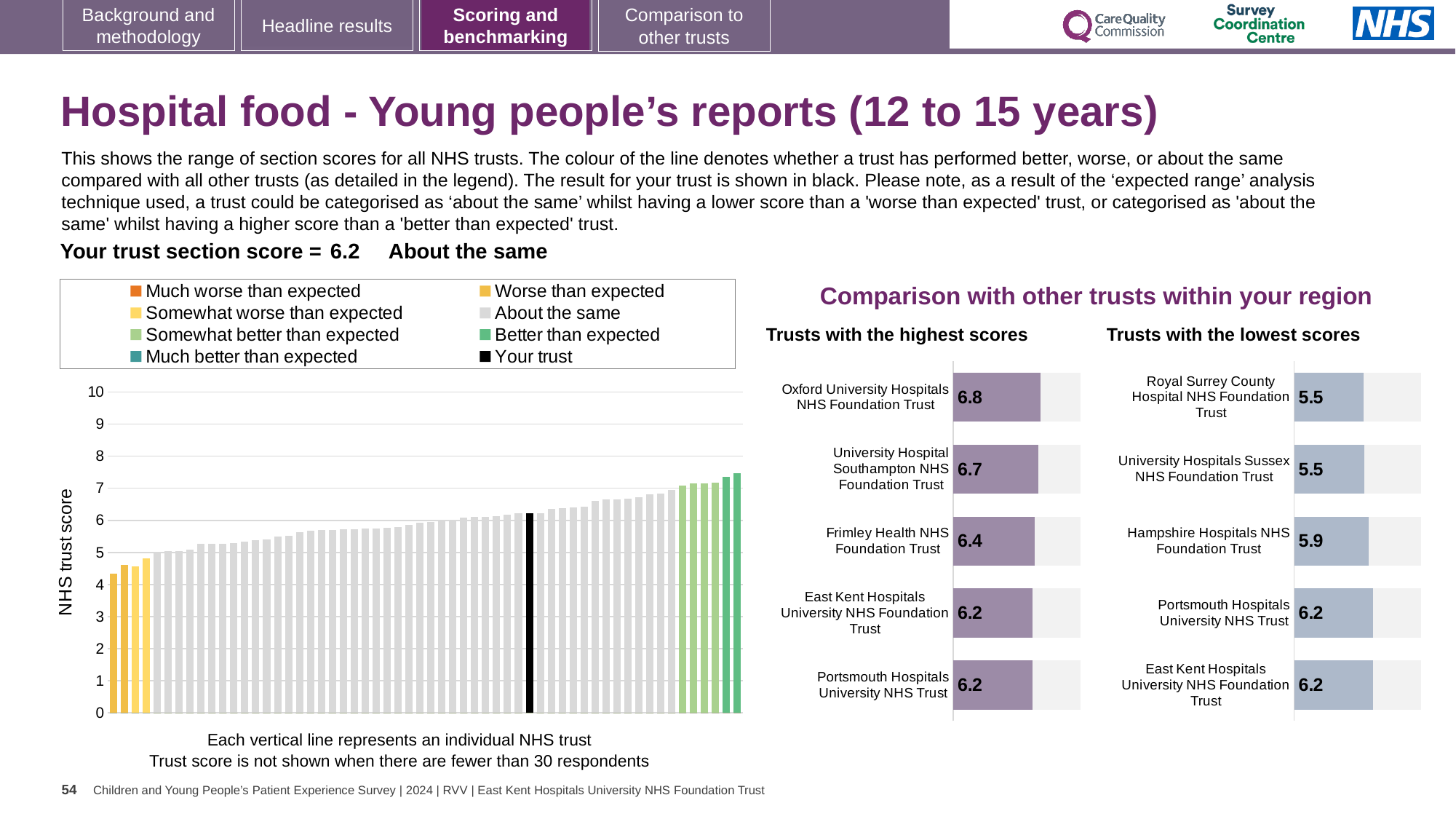
In the 'Trusts with the highest scores' chart, which trust has the highest score? Oxford University Hospitals NHS Foundation Trust In the 'Trusts with the lowest scores' chart, what is the score for Royal Surrey County Hospital NHS Foundation Trust? 5.5 In the NHS trust score chart on the left, do the trust scores rise or fall from left to right? rise How many entries does the legend of the NHS trust score chart on the left list? 8 In the NHS trust score chart on the left, what is the section score for your trust (the black bar)? 6.2 What kind of chart is the NHS trust score chart on the left? bar chart In the 'Trusts with the highest scores' chart, what is the score for Oxford University Hospitals NHS Foundation Trust? 6.8 In the 'Trusts with the highest scores' chart, how many trusts are shown? 5 In the 'Trusts with the lowest scores' chart, which is larger: the score for Hampshire Hospitals NHS Foundation Trust or University Hospitals Sussex NHS Foundation Trust? Hampshire Hospitals NHS Foundation Trust In the 'Trusts with the highest scores' chart, what is the difference between the scores of Oxford University Hospitals NHS Foundation Trust and Frimley Health NHS Foundation Trust? 0.4 In the 'Trusts with the lowest scores' chart, what is the score for Hampshire Hospitals NHS Foundation Trust? 5.9 In the 'Trusts with the lowest scores' chart, what is the difference between the scores of Portsmouth Hospitals University NHS Trust and Royal Surrey County Hospital NHS Foundation Trust? 0.7